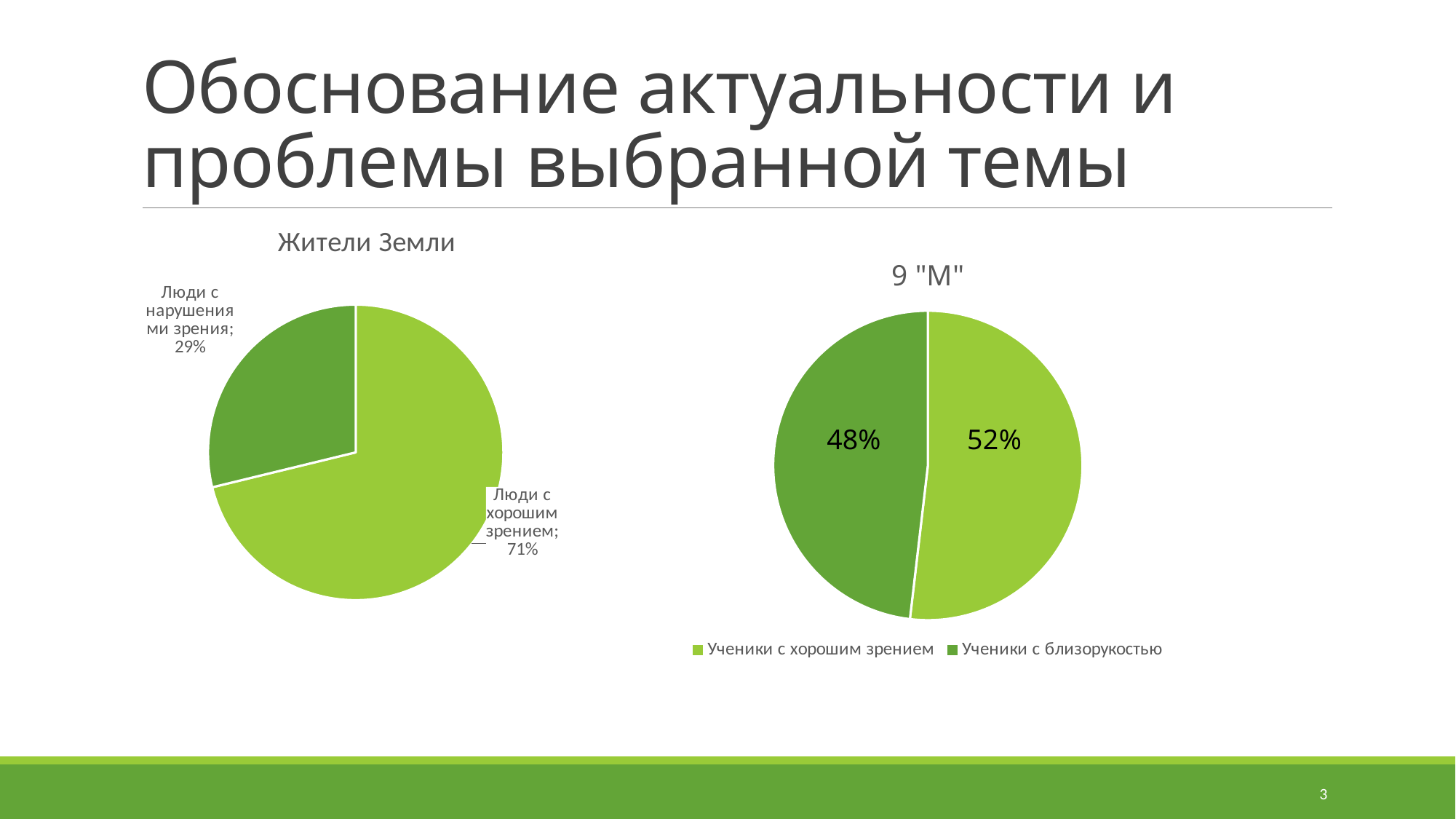
In the "Жители Земли" chart, what share is labelled for "Люди с нарушениями зрения"? 29% In the "Жители Земли" chart, what share is labelled for "Люди с хорошим зрением"? 71% In the "Жители Земли" chart, which slice is the smallest? Люди с нарушениями зрения How many entries does the legend of the "9 "М"" chart list? 2 What kind of chart is the "Жители Земли" chart? Pie chart In the "9 "М"" chart, what share is labelled for "Ученики с хорошим зрением"? 52% In the "9 "М"" chart, what is the difference in percentage points between the two slices? 4 In the "9 "М"" chart, which slice is larger? Ученики с хорошим зрением How many slices does the "Жители Земли" chart have? 2 In the "9 "М"" chart, what share is labelled for "Ученики с близорукостью"? 48% In the "Жители Земли" chart, which slice is the largest? Люди с хорошим зрением In the "Жители Земли" chart, what is the difference in percentage points between the two slices? 42